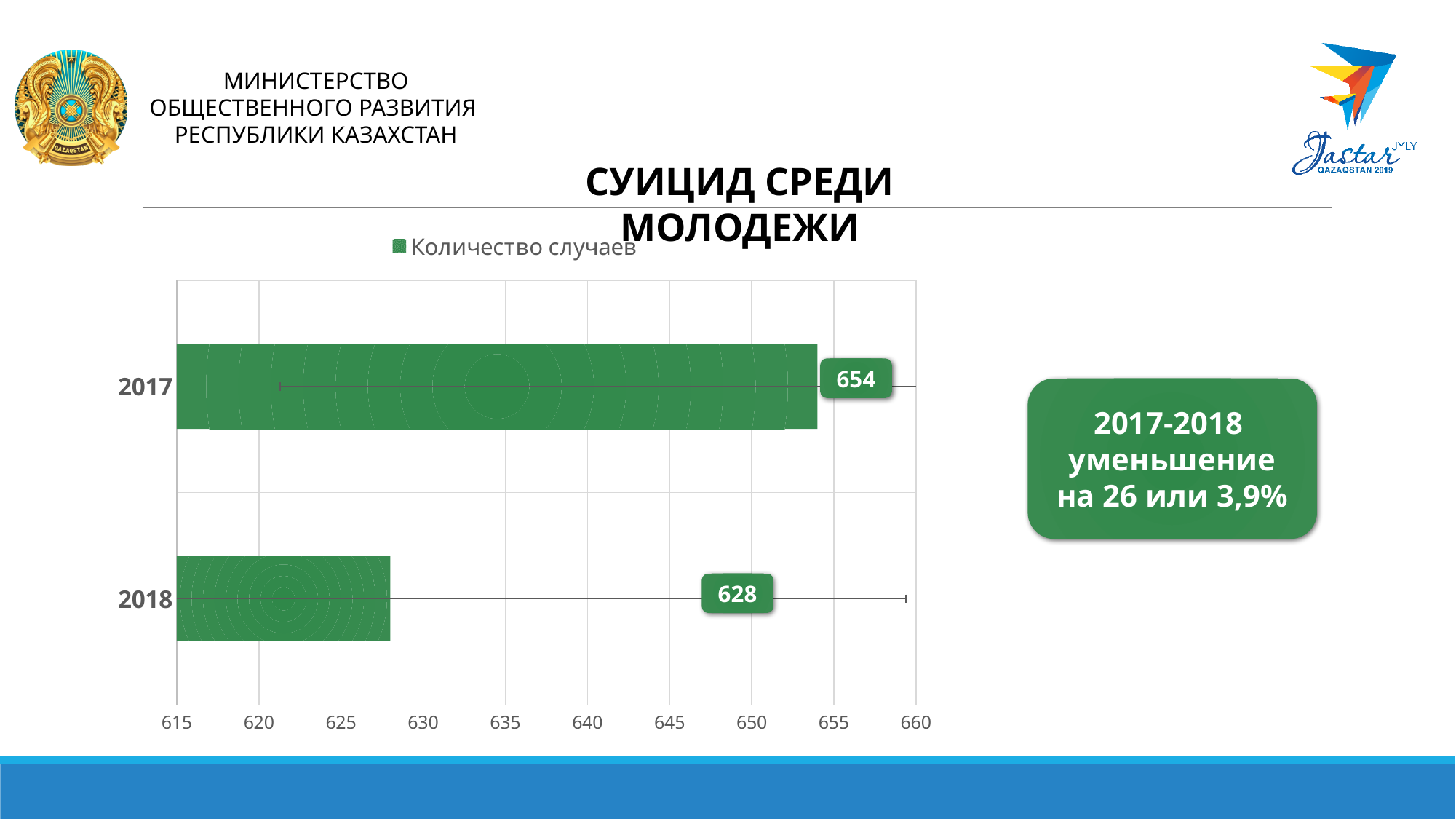
What is the value for 2017? 654 How many categories are shown on the chart? 2 Which year has the lowest number of cases? 2018 What is the value for 2018? 628 What kind of chart is shown on the slide? bar chart What is the legend entry of the series shown on the chart? Количество случаев Is the value for 2017 greater or less than 650? greater Which is larger, the value for 2017 or the value for 2018? 2017 Is the value for 2018 greater or less than 630? less What is the difference between the values for 2017 and 2018? 26 How many series does the legend list? 1 Which year has the highest number of cases? 2017